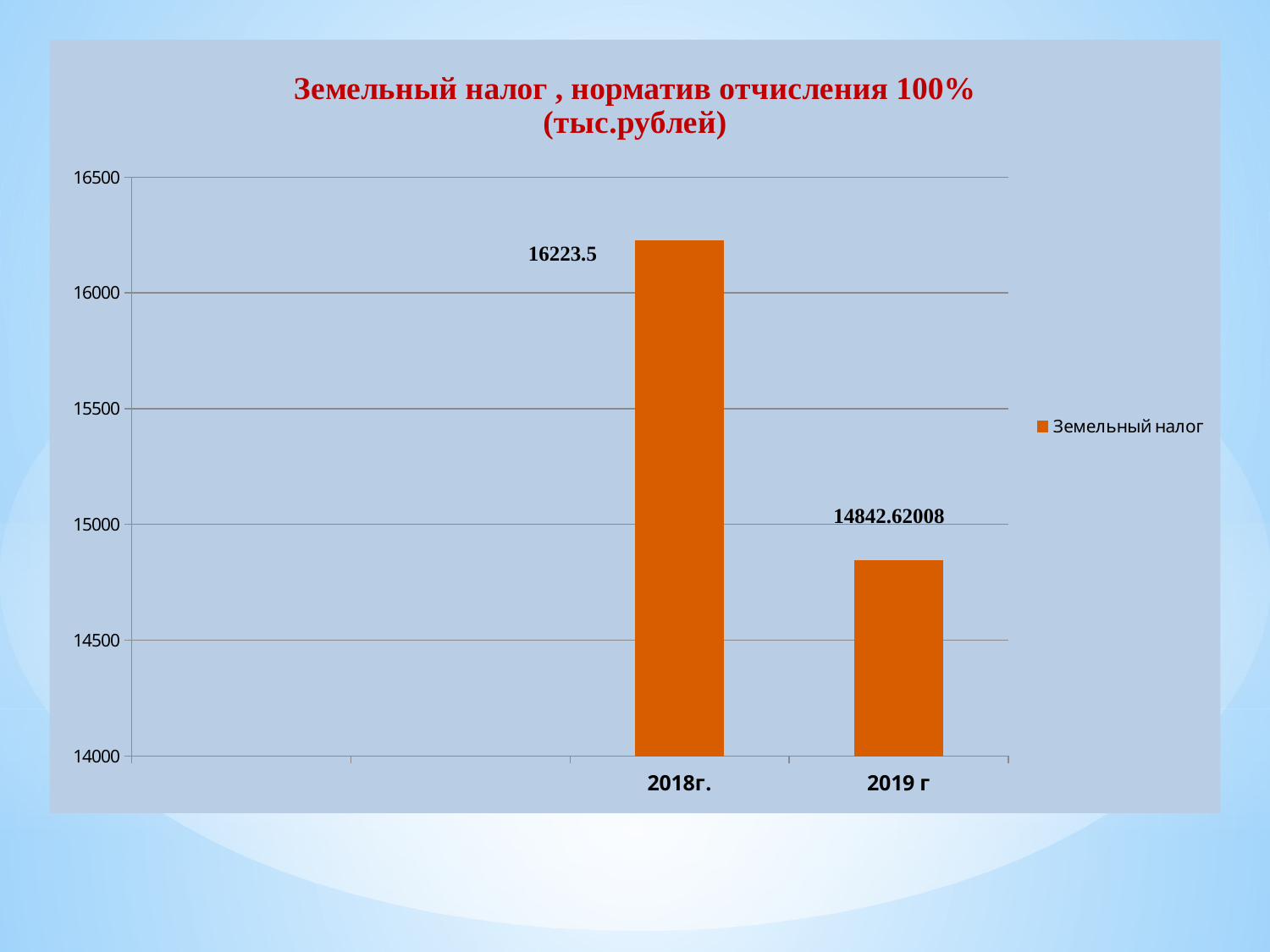
What is the difference between the values for 2018г. and 2019 г? 1380.87992 How many series does the legend list? 1 Is the value for 2018г. greater or less than 16000? greater What is the value for 2019 г? 14842.62008 How many categories are shown on the x axis? 2 Which year has the highest value? 2018г. Which year has the lowest value? 2019 г What kind of chart is shown on the slide? bar chart Which is larger, the value for 2018г. or the value for 2019 г? 2018г. What is the name of the series shown in the legend? Земельный налог Is the value for 2019 г greater or less than 15000? less What is the value for 2018г.? 16223.5